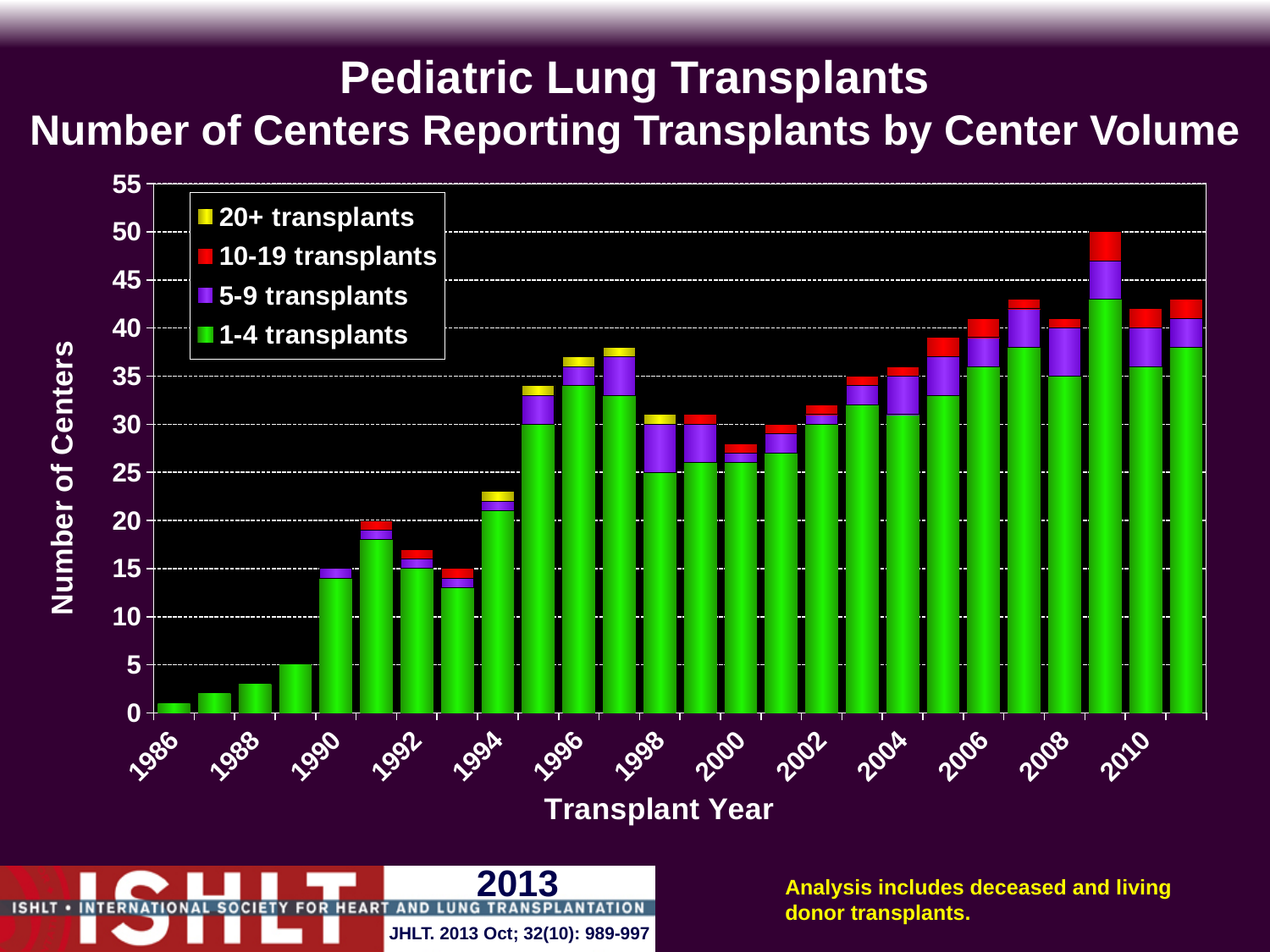
What kind of chart is shown on the slide? Stacked bar chart Which transplant year has the highest total number of centers? 2009 Is the total number of centers for 1992 greater or less than 20? less Which colour represents the '20+ transplants' series in the legend? Yellow How many series does the legend list? 4 Which year has more centers reporting in total, 2009 or 2007? 2009 Which transplant year has the lowest total number of centers? 1986 Is the total number of centers for 2000 greater or less than 30? less Which year has more centers reporting in total, 1995 or 2000? 1995 Is the total number of centers for 1995 greater or less than 30? greater Do the total number of centers rise or fall from 1986 to 1991? rise